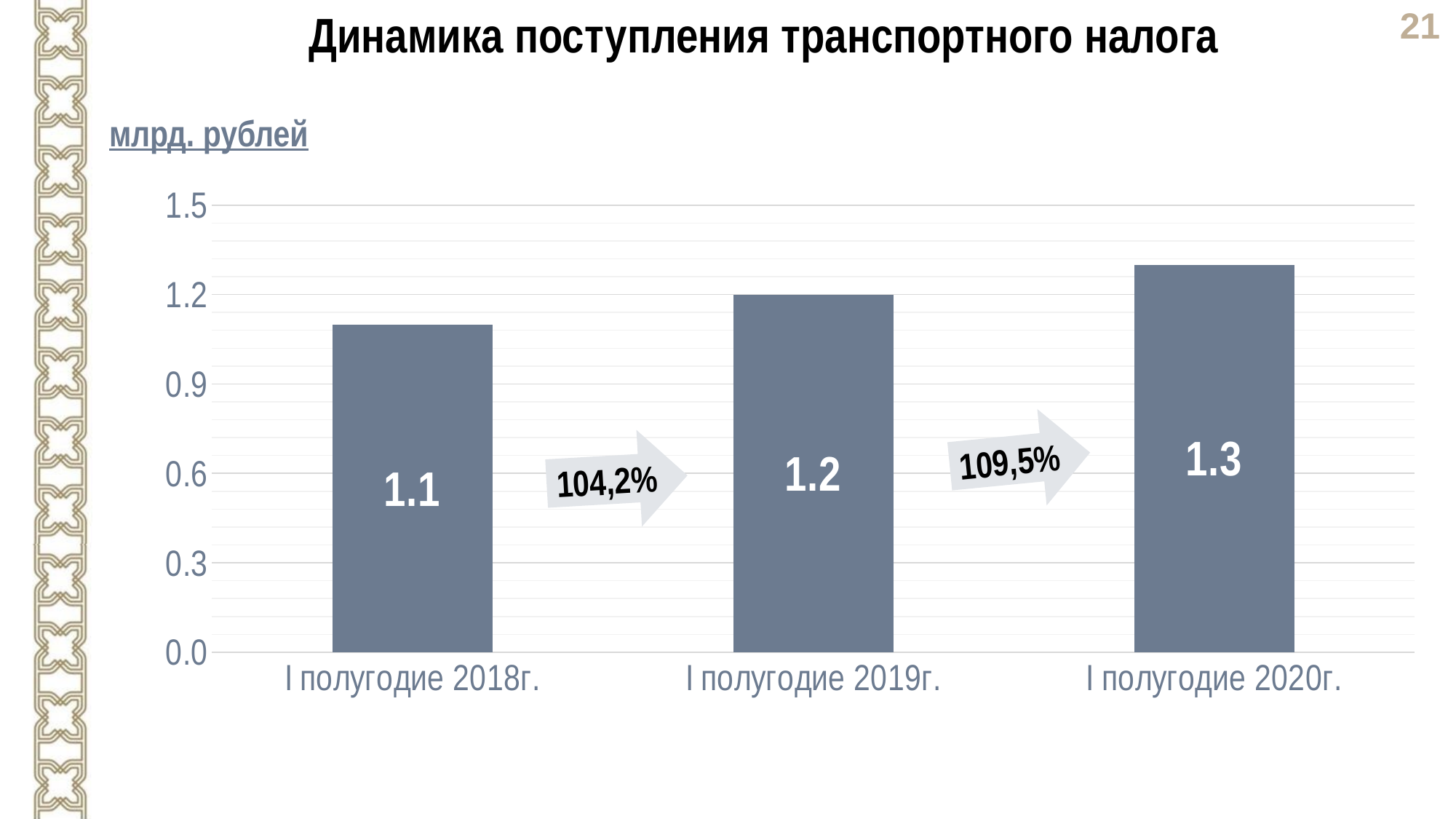
What is the title of the chart? Динамика поступления транспортного налога Which is larger, the value for I полугодие 2019г. or I полугодие 2018г.? I полугодие 2019г. What is the value for I полугодие 2019г.? 1.2 Do the values rise or fall from I полугодие 2018г. to I полугодие 2020г.? rise What is the difference between the values for I полугодие 2020г. and I полугодие 2018г.? 0.2 What is the value for I полугодие 2020г.? 1.3 How many periods are shown on the chart? 3 Which period has the lowest value? I полугодие 2018г. What is the value for I полугодие 2018г.? 1.1 Is the value for I полугодие 2020г. greater or less than 1.5? less Which period has the highest value? I полугодие 2020г. What kind of chart is shown on the slide? bar chart